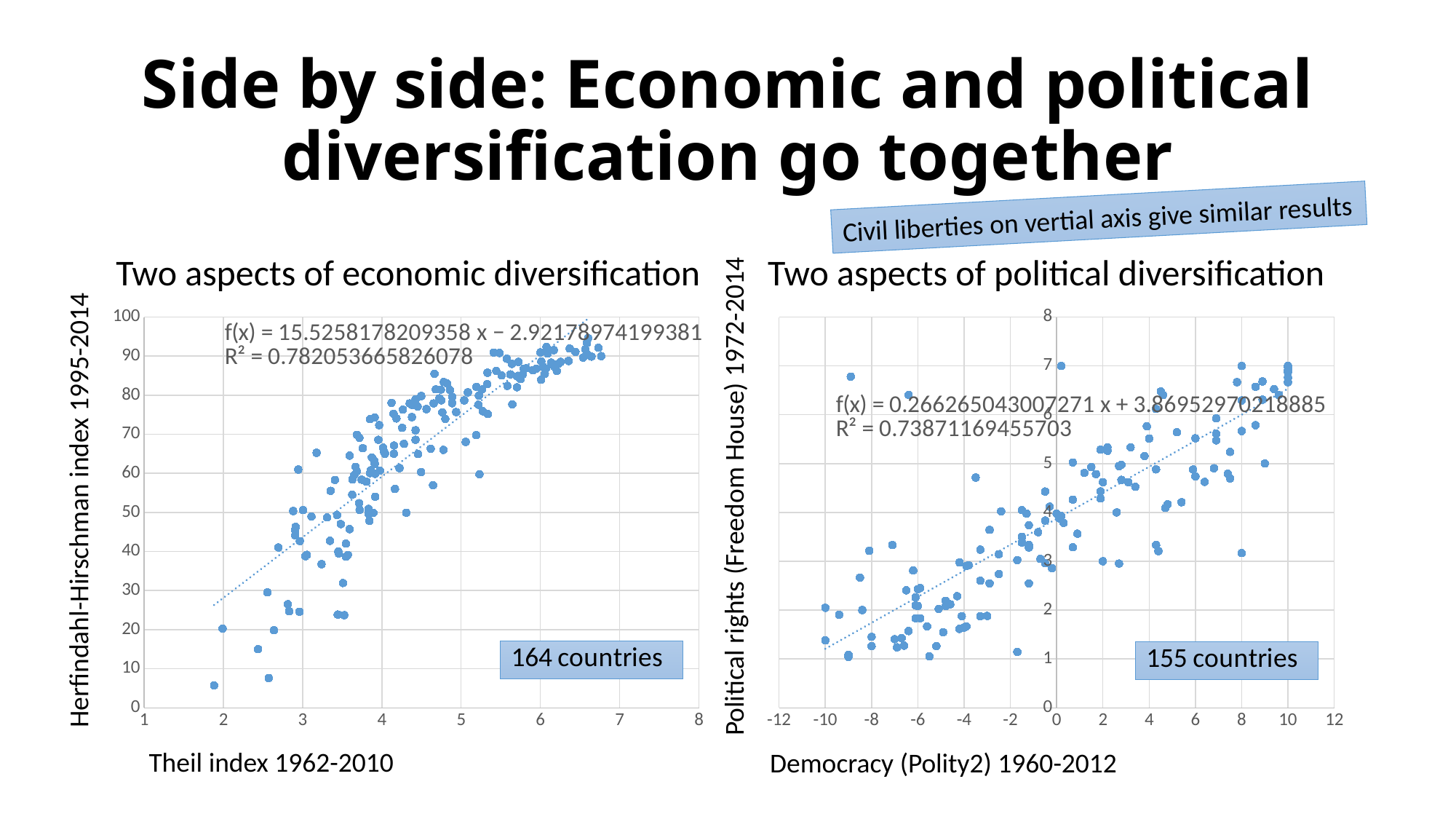
How many more countries are plotted in the economic diversification chart than in the political diversification chart? 9 What is the R² value shown on the 'Two aspects of economic diversification' chart? 0.782053665826078 What kind of chart is the 'Two aspects of political diversification' chart? scatter chart In the 'Two aspects of political diversification' chart, do the points generally rise or fall as Democracy (Polity2) increases? rise How many countries are plotted in the 'Two aspects of economic diversification' chart? 164 countries Which chart has the higher R² value, the economic diversification chart or the political diversification chart? the economic diversification chart What is the y-axis label of the 'Two aspects of economic diversification' chart? Herfindahl-Hirschman index 1995-2014 What kind of chart is the 'Two aspects of economic diversification' chart? scatter chart What is the R² value shown on the 'Two aspects of political diversification' chart? 0.73871169455703 What is the x-axis label of the 'Two aspects of political diversification' chart? Democracy (Polity2) 1960-2012 How many countries are plotted in the 'Two aspects of political diversification' chart? 155 countries In the 'Two aspects of economic diversification' chart, do the points generally rise or fall as the Theil index increases? rise